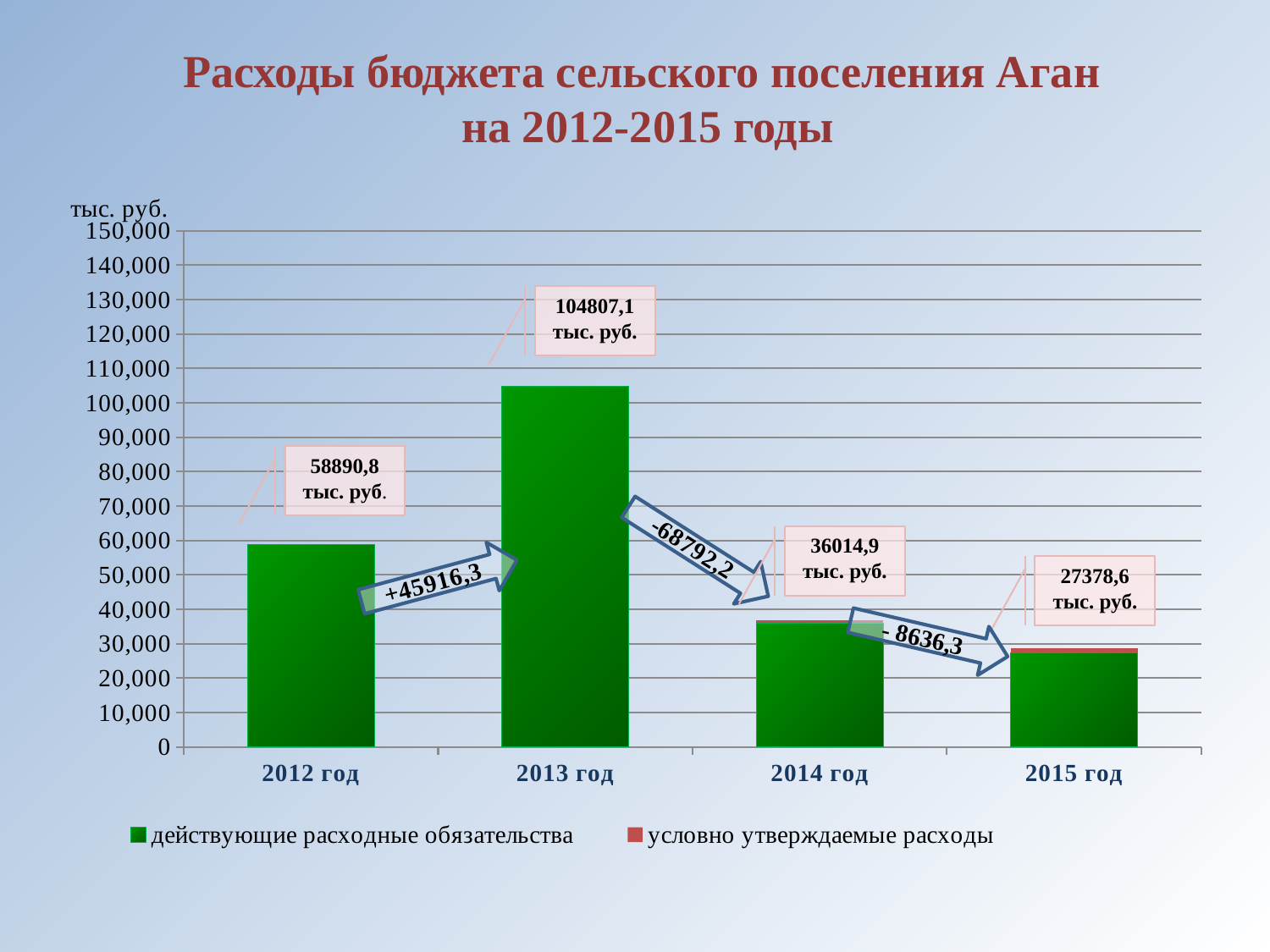
Which year has the highest total expenditure? 2013 год How many years are shown on the x axis? 4 What is the total budget expenditure shown for 2012 год? 58890,8 тыс. руб. How many series does the legend list? 2 What is the total budget expenditure shown for 2013 год? 104807,1 тыс. руб. Do the values rise or fall from 2013 год to 2015 год? fall Which year has the lowest total expenditure? 2015 год By how much does the total expenditure for 2013 год exceed that for 2012 год? 45916,3 Which is larger, the total expenditure for 2012 год or for 2014 год? 2012 год